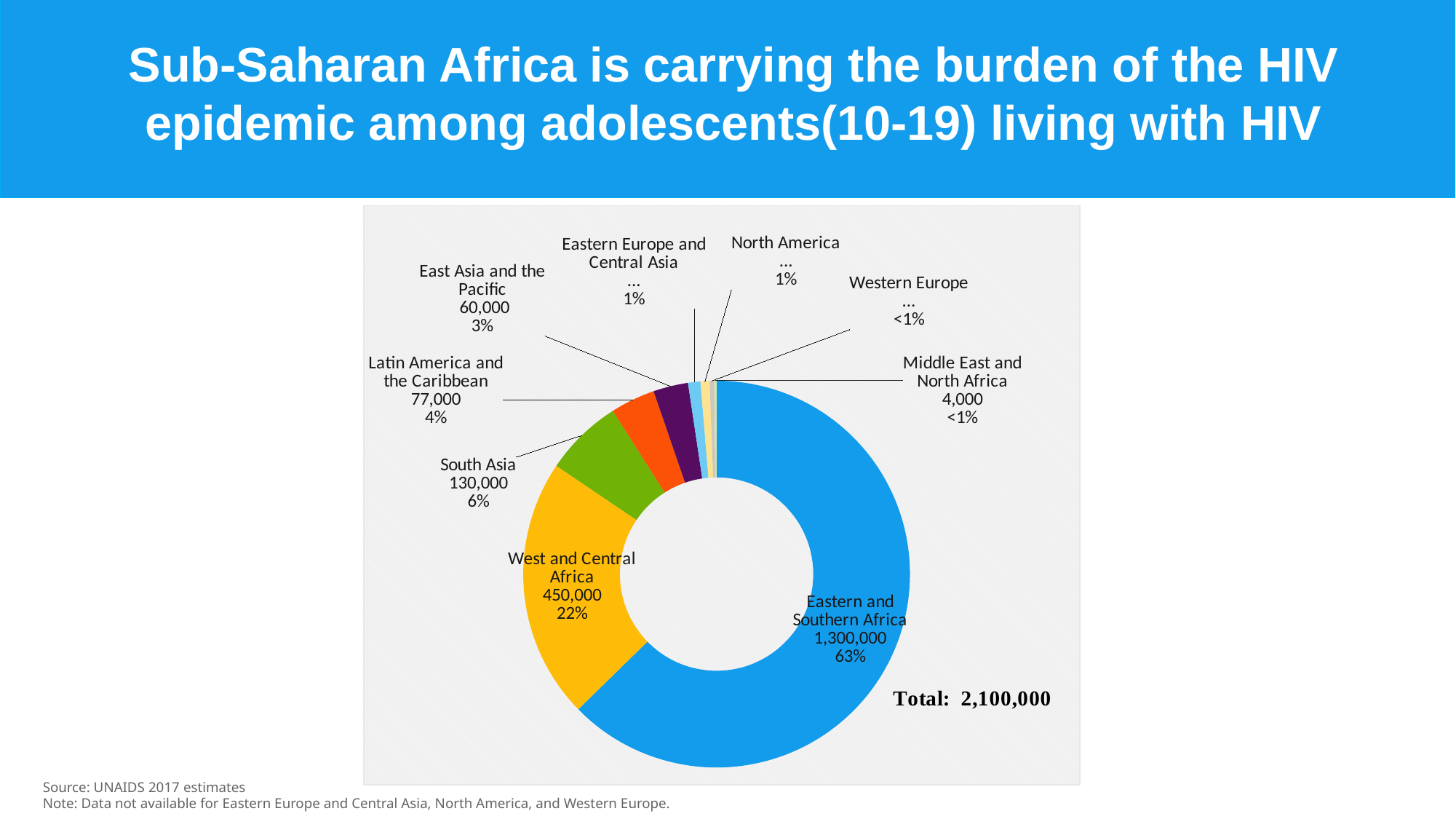
What share of the pie does West and Central Africa represent? 22% Which is larger, the value for Latin America and the Caribbean or the value for East Asia and the Pacific? Latin America and the Caribbean What total is printed on the chart? 2,100,000 What is the value shown for Middle East and North Africa? 4,000 What type of chart is shown on the slide? Pie chart (donut) What is the difference between the values for Eastern and Southern Africa and West and Central Africa? 850,000 How many regions are shown in the chart? 9 How many adolescents living with HIV are in Eastern and Southern Africa? 1,300,000 What is the value shown for West and Central Africa? 450,000 Which region has the largest share of the pie? Eastern and Southern Africa What is the value shown for South Asia? 130,000 What share of the pie does East Asia and the Pacific represent? 3%